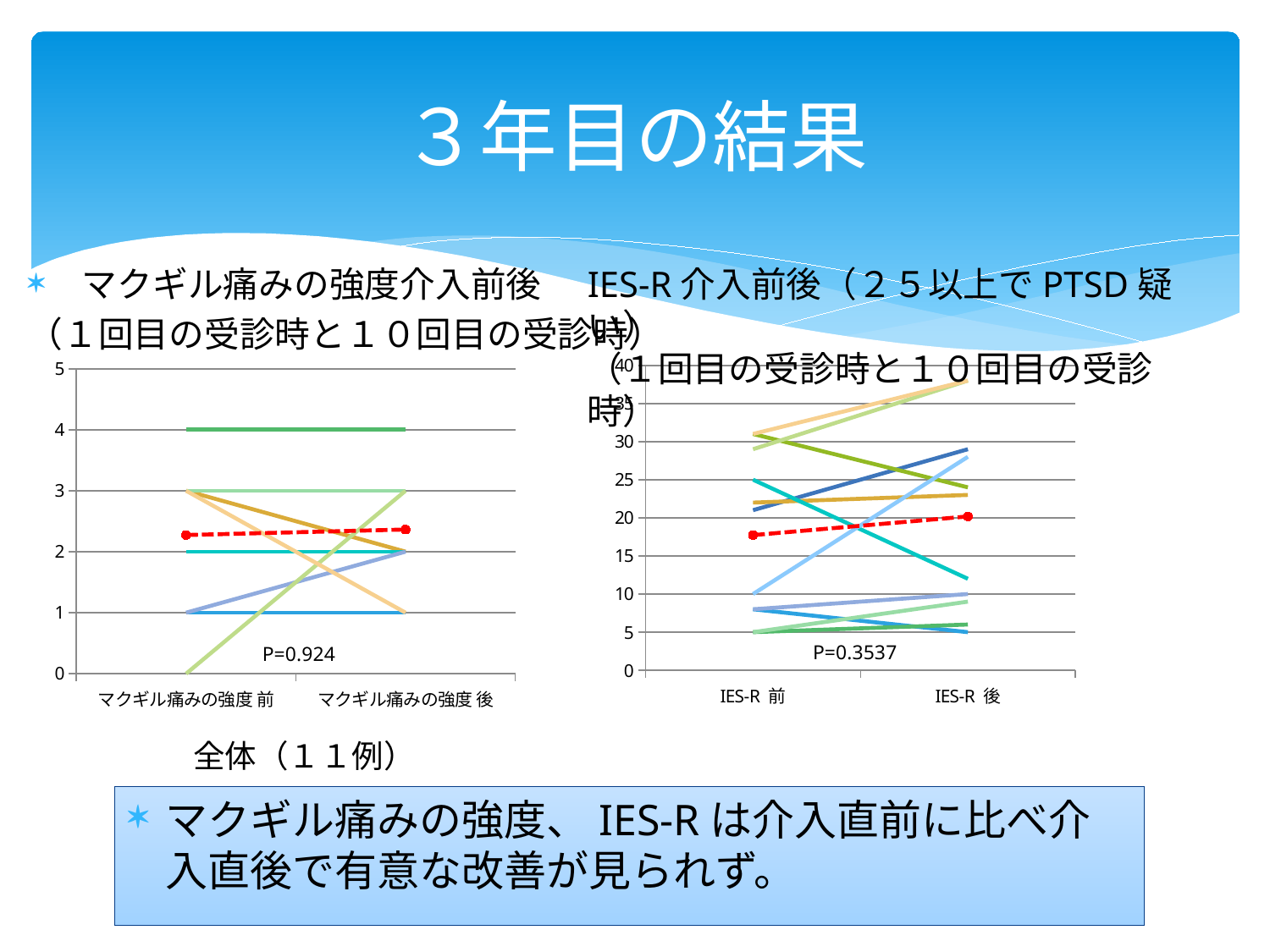
In the left chart (マクギル痛みの強度), what is the lowest value plotted at マクギル痛みの強度 前? 0 In the right chart (IES-R), what is the lowest value plotted at IES-R 前? 5 What P value is printed on the right chart (IES-R)? P=0.3537 What kind of chart is the right chart (IES-R)? line chart What P value is printed on the left chart (マクギル痛みの強度)? P=0.924 In the right chart (IES-R), is the highest value plotted at IES-R 後 greater or less than 35? greater In the left chart (マクギル痛みの強度), what is the lowest value plotted at マクギル痛みの強度 後? 1 In the left chart (マクギル痛みの強度), what is the highest value plotted at マクギル痛みの強度 前? 4 How many categories are on the x axis of the right chart (IES-R)? 2 How many categories are on the x axis of the left chart (マクギル痛みの強度)? 2 In the right chart (IES-R), is the highest value plotted at IES-R 前 greater or less than 25? greater What kind of chart is the left chart (マクギル痛みの強度)? line chart